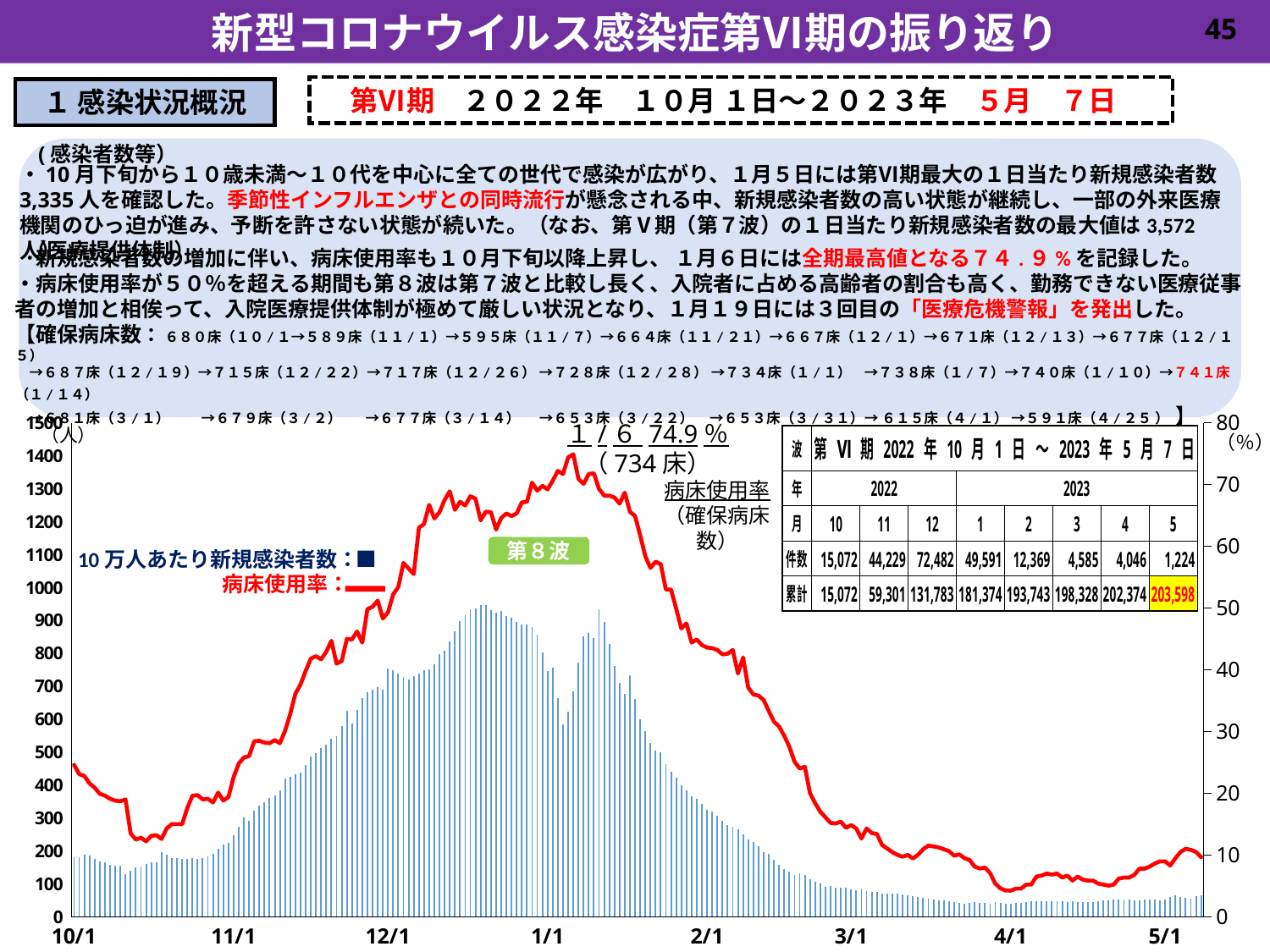
Is the 病床使用率 higher on 1/1 or on 4/1? 1/1 Is the 10万人あたり新規感染者数 bar around 1/1 greater or less than 500? greater Is the 病床使用率 around 3/1 greater or less than 20%? less What wave label is shown in the green box on the chart? 第8波 What is the peak 病床使用率 value annotated on the chart? 74.9% Do the 10万人あたり新規感染者数 bars rise or fall between 11/1 and 12/1? rise Does the 病床使用率 line rise or fall between 2/1 and 3/1? fall On what date did the 病床使用率 reach its annotated peak of 74.9%? 1/6 What 確保病床数 is shown in parentheses next to the 74.9% annotation? 734床 What kind of chart is shown on the slide? A combined bar and line chart How many series does the chart's legend list? 2 Is the 病床使用率 at 10/1 greater or less than 20%? greater